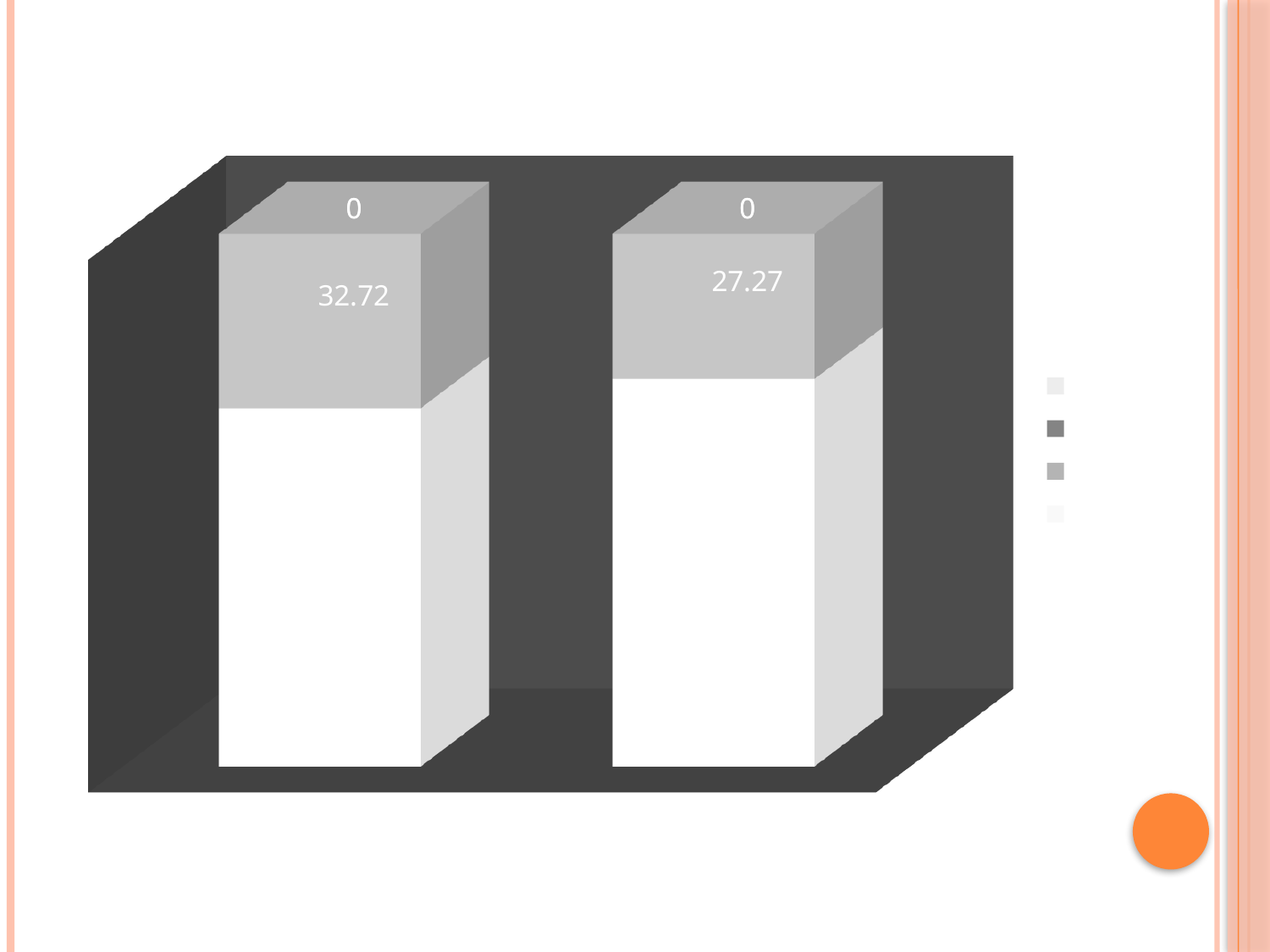
How many colour entries does the legend show? 4 Is the labelled grey segment of the left bar greater or less than the labelled grey segment of the right bar? greater Which bar has the larger labelled grey segment, the left or the right? left What is the difference between the labelled grey segment values of the left bar (32.72) and the right bar (27.27)? 5.45 What value is printed on the grey segment of the left bar? 32.72 What value is printed on the grey segment of the right bar? 27.27 What colour is the segment labelled 32.72? grey How many bars does the chart show? 2 What value is printed at the top of each bar? 0 What kind of chart is shown on the slide? bar chart